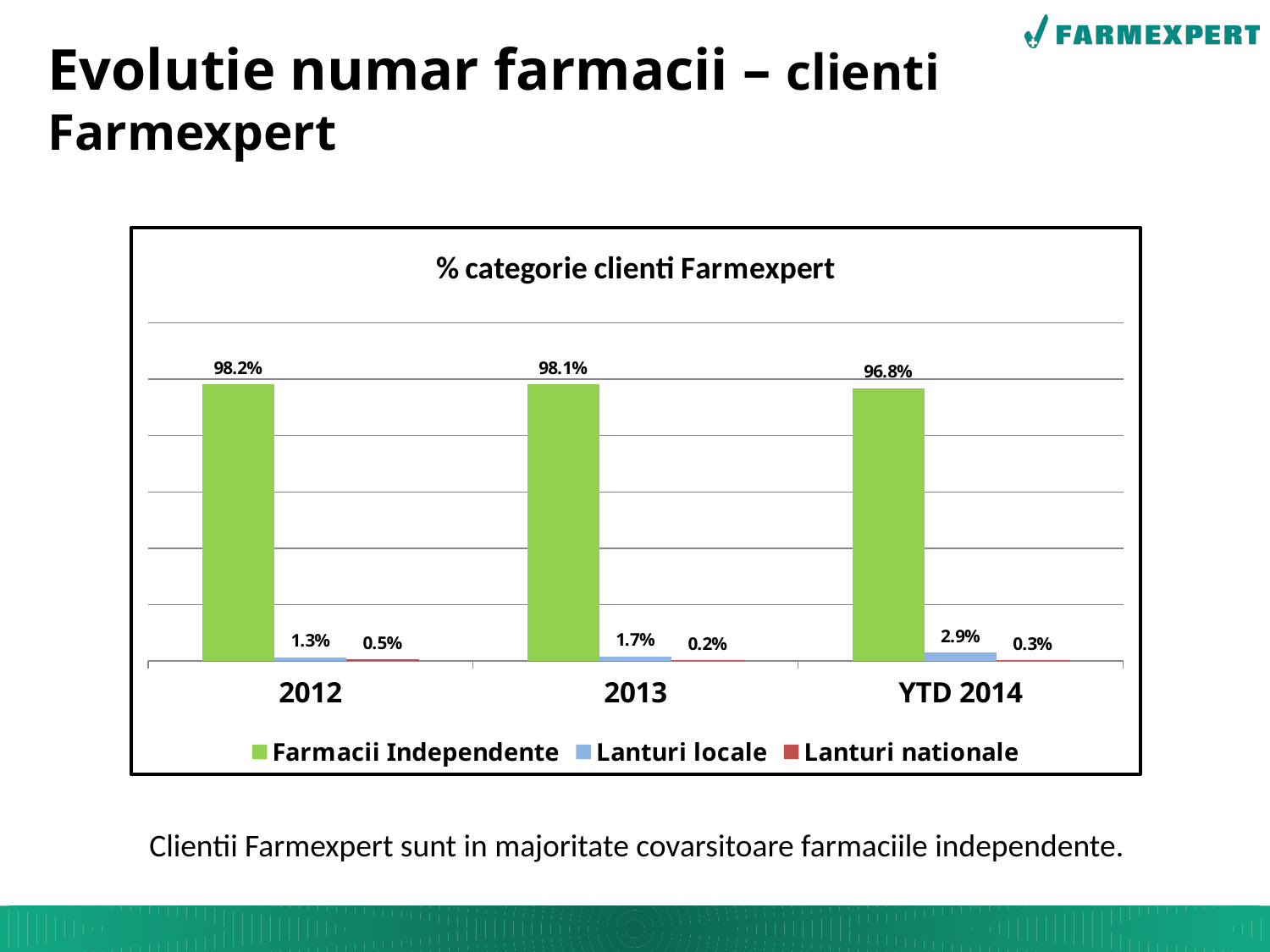
What is the value for Farmacii Independente in 2012? 98.2% In which year is the value for Farmacii Independente lowest? YTD 2014 In which year is the value for Lanturi locale highest? YTD 2014 Which is larger in 2012: Lanturi locale or Lanturi nationale? Lanturi locale Does the value for Farmacii Independente rise or fall from 2012 to YTD 2014? Fall What is the value for Lanturi locale in 2013? 1.7% How many categories are shown on the x axis? 3 What is the difference between the Farmacii Independente values for 2012 and YTD 2014? 1.4% How many series does the legend list? 3 What is the value for Lanturi locale in YTD 2014? 2.9% What is the value for Lanturi nationale in 2013? 0.2% What kind of chart is shown? Bar chart